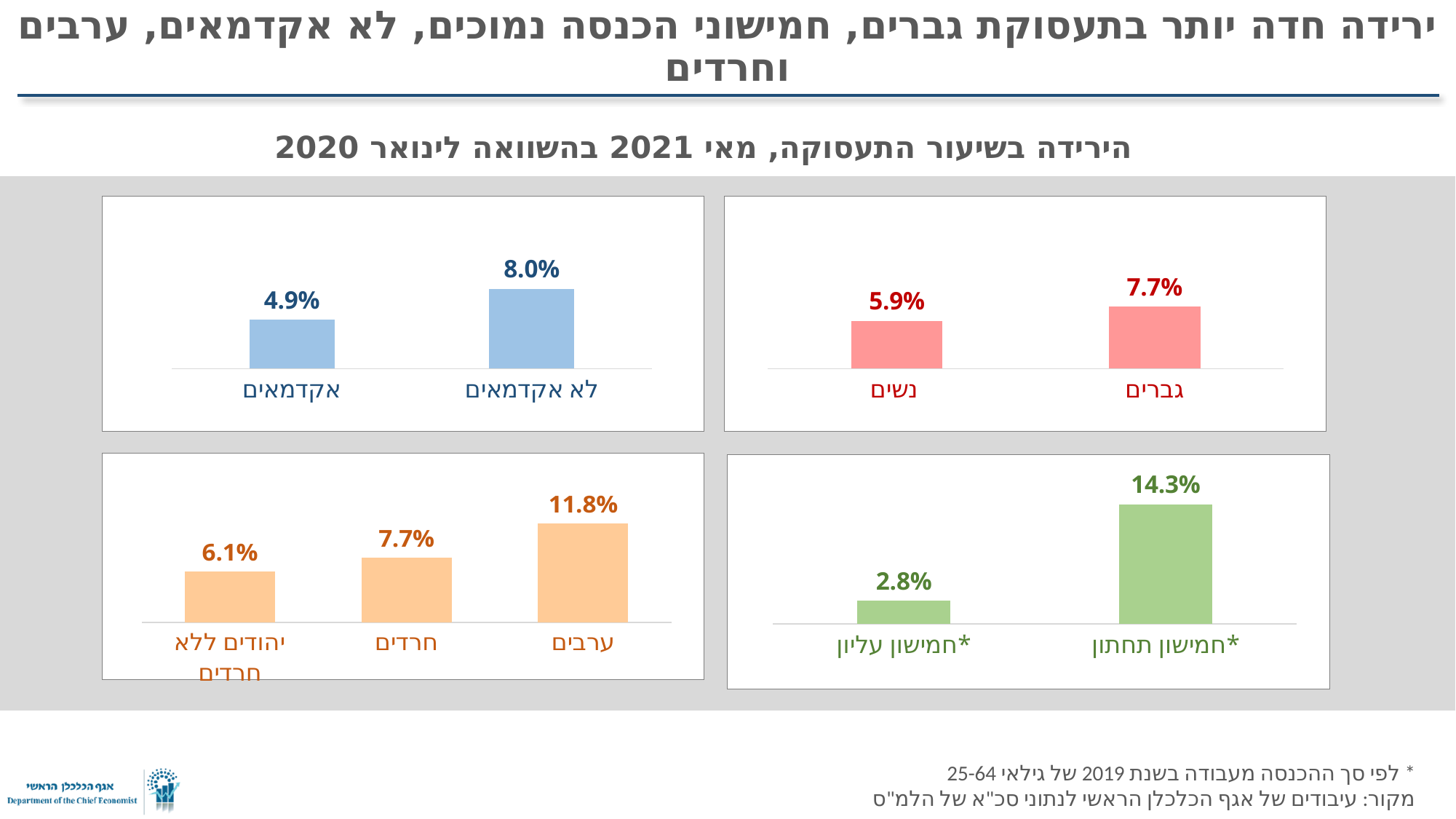
In the bottom-left chart, which category has the lowest value? יהודים ללא חרדים What type of chart is the bottom-right chart? Bar chart In the top-left chart, which is larger, the value for אקדמאים or the value for לא אקדמאים? לא אקדמאים In the top-left chart, what is the value for אקדמאים? 4.9% In the top-right chart, what is the value for גברים? 7.7% In the bottom-left chart, what is the value for חרדים? 7.7% In the top-right chart, what is the difference between the values for גברים and נשים? 1.8% In the top-left chart, what is the value for לא אקדמאים? 8.0% In the bottom-right chart, what is the difference between the values for חמישון תחתון* and חמישון עליון*? 11.5% In the bottom-left chart, which category has the highest value? ערבים How many categories are shown in the bottom-left chart? 3 In the bottom-right chart, what is the value for חמישון תחתון*? 14.3%